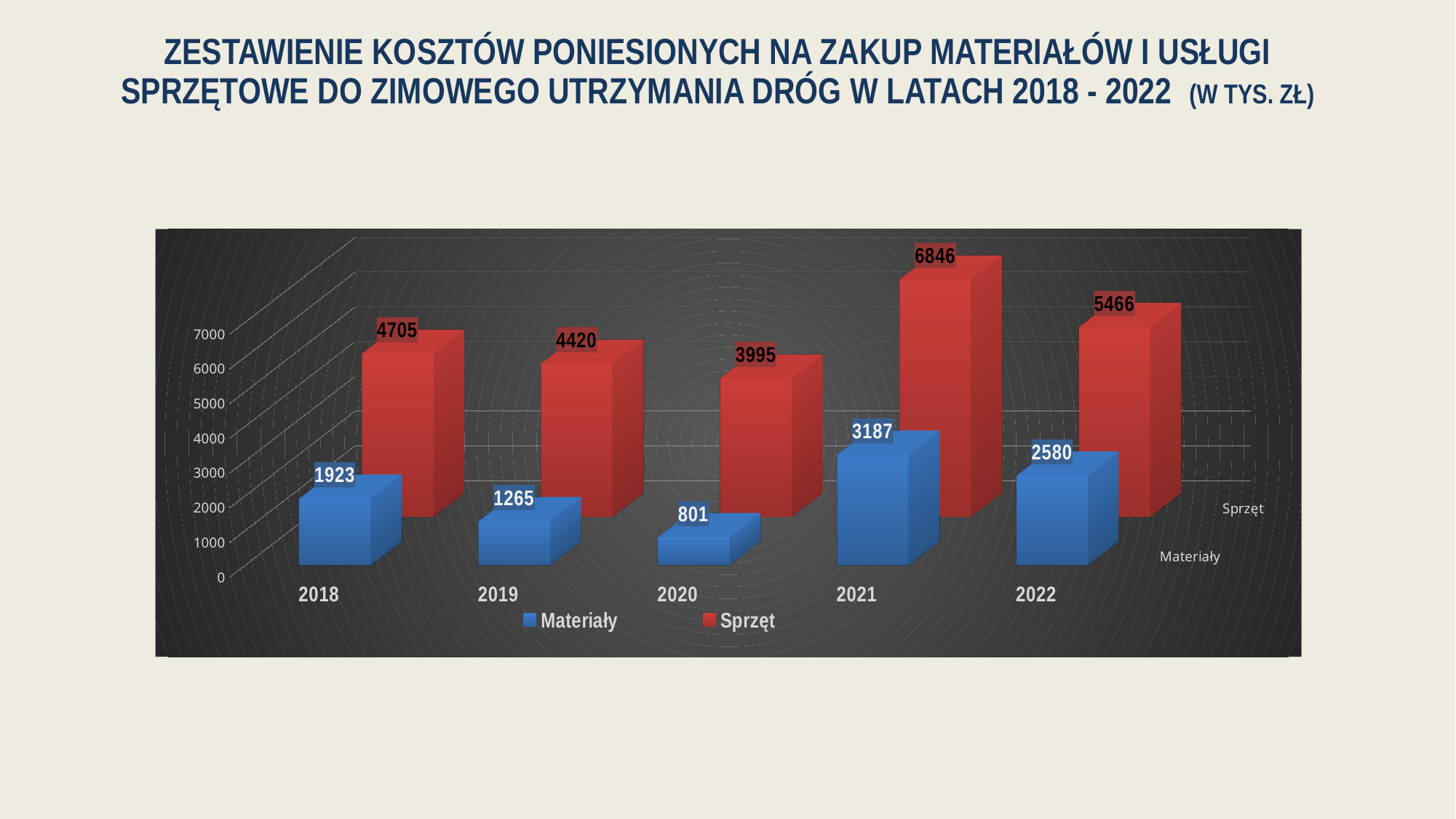
What is the value for Sprzęt in 2018? 4705 What is the value for Materiały in 2022? 2580 What is the value for Sprzęt in 2021? 6846 In which year is the Materiały value lowest? 2020 How many years are shown on the x axis? 5 Which colour represents the Sprzęt series? Red How many series does the legend list? 2 In which year is the Sprzęt value highest? 2021 Which is larger, the Sprzęt value in 2022 or the Sprzęt value in 2020? Sprzęt in 2022 What is the difference between the Sprzęt and Materiały values in 2019? 3155 What kind of chart is shown on the slide? Bar chart What is the value for Materiały in 2020? 801